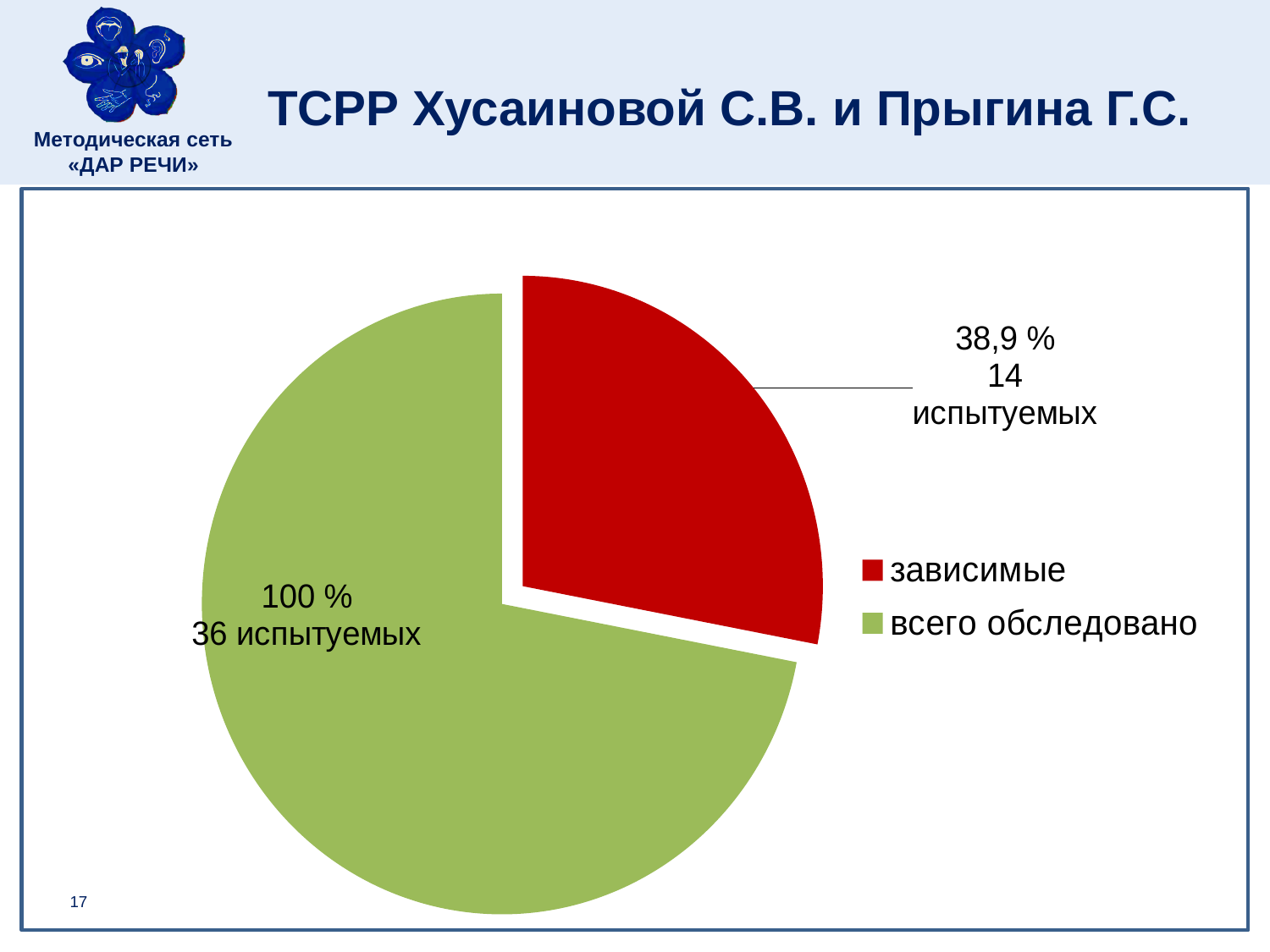
Which slice of the pie chart is the smallest? зависимые What percentage is printed on the зависимые slice? 38,9 % How many slices does the pie chart have? 2 What kind of chart is shown on the slide? pie chart How many испытуемых are shown for the зависимые slice? 14 испытуемых How many испытуемых are shown for the всего обследовано slice? 36 испытуемых What colour is the зависимые slice in the pie chart? red What percentage is printed on the всего обследовано slice? 100 % Which has more испытуемых, зависимые or всего обследовано? всего обследовано Which slice of the pie chart is the largest? всего обследовано What is the difference in испытуемых between всего обследовано and зависимые? 22 How many entries does the legend of the pie chart list? 2